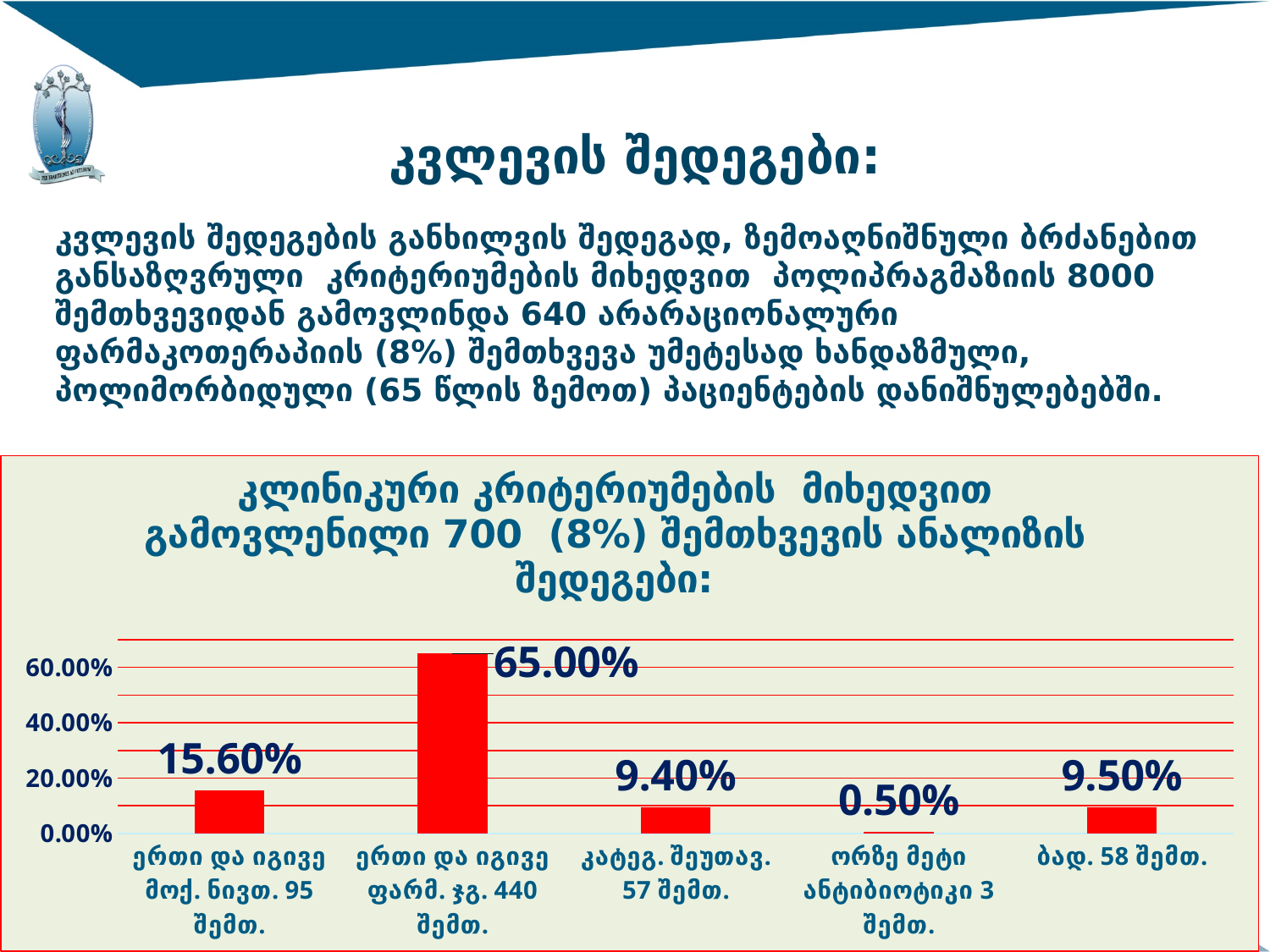
How many categories are shown in the chart? 5 Which category has the lowest value? ორზე მეტი ანტიბიოტიკი 3 შემთ. What is the value for the category 'ორზე მეტი ანტიბიოტიკი 3 შემთ.'? 0.50% What is the value for the category 'კატეგ. შეუთავ. 57 შემთ.'? 9.40% Is the value for 'ერთი და იგივე ფარმ. ჯგ. 440 შემთ.' greater or less than 60.00%? greater Which category has the highest value? ერთი და იგივე ფარმ. ჯგ. 440 შემთ. What is the difference between the values for 'ერთი და იგივე ფარმ. ჯგ. 440 შემთ.' and 'ერთი და იგივე მოქ. ნივთ. 95 შემთ.'? 49.40% What is the value for the category 'ერთი და იგივე ფარმ. ჯგ. 440 შემთ.'? 65.00% What is the value for the category 'ბად. 58 შემთ.'? 9.50% What kind of chart is shown on the slide? bar chart Which is larger, the value for 'ერთი და იგივე მოქ. ნივთ. 95 შემთ.' or the value for 'კატეგ. შეუთავ. 57 შემთ.'? ერთი და იგივე მოქ. ნივთ. 95 შემთ. What is the value for the category 'ერთი და იგივე მოქ. ნივთ. 95 შემთ.'? 15.60%